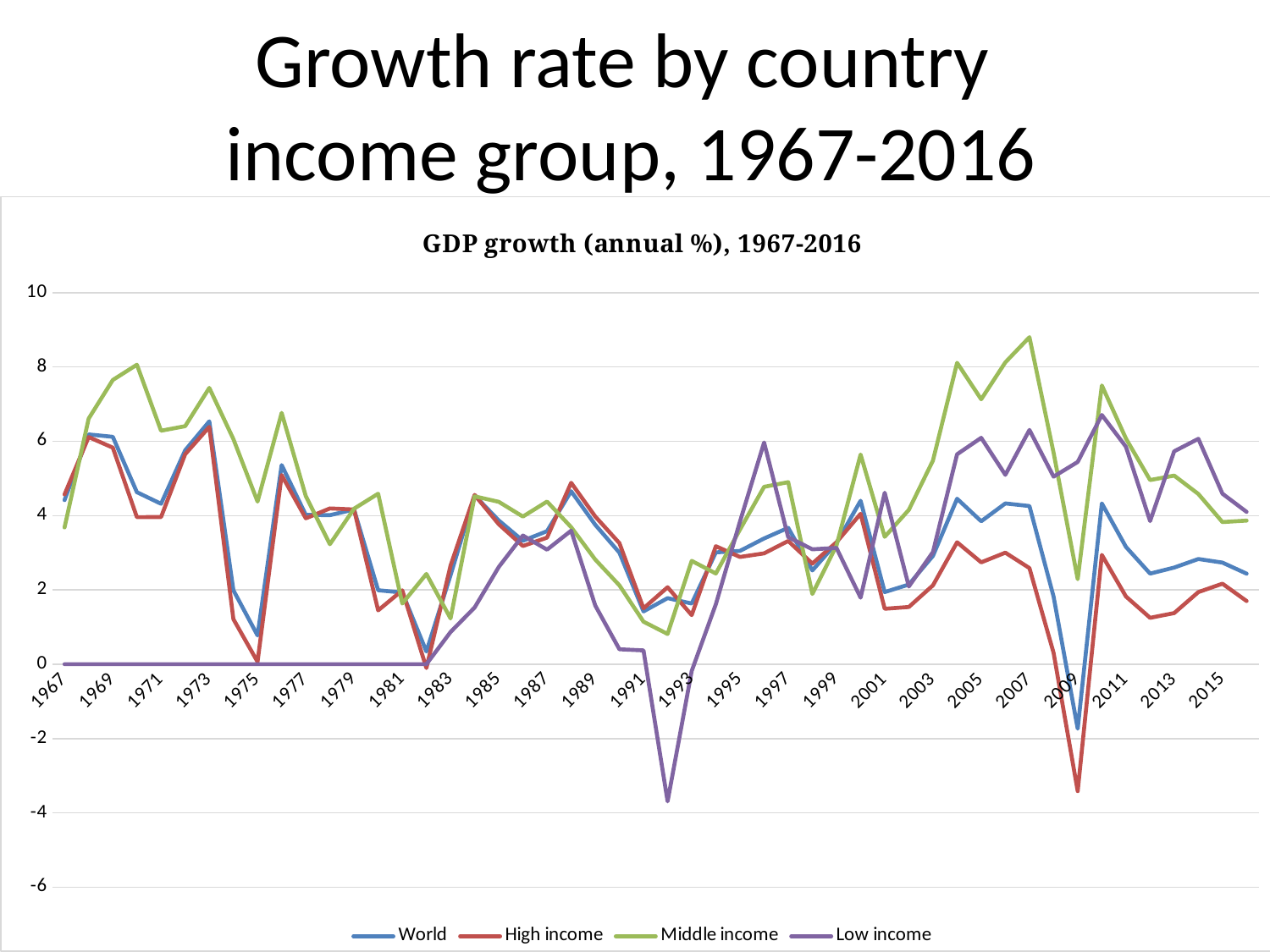
How many series does the legend list? 4 Is the value for High income in 2009 greater or less than -2? less Does the World series rise or fall from 2010 to 2016? Fall Which series has the highest value in 2007? Middle income Is the value for Middle income in 1969 greater or less than 6? greater Is the value for Low income in 1992 greater or less than -2? less What kind of chart is shown on the slide? Line chart Which series has the lowest value in 2009? High income What is the title of the chart? GDP growth (annual %), 1967-2016 Which colour is used for the Low income series? Purple In 2009, which is larger: the World value or the High income value? World